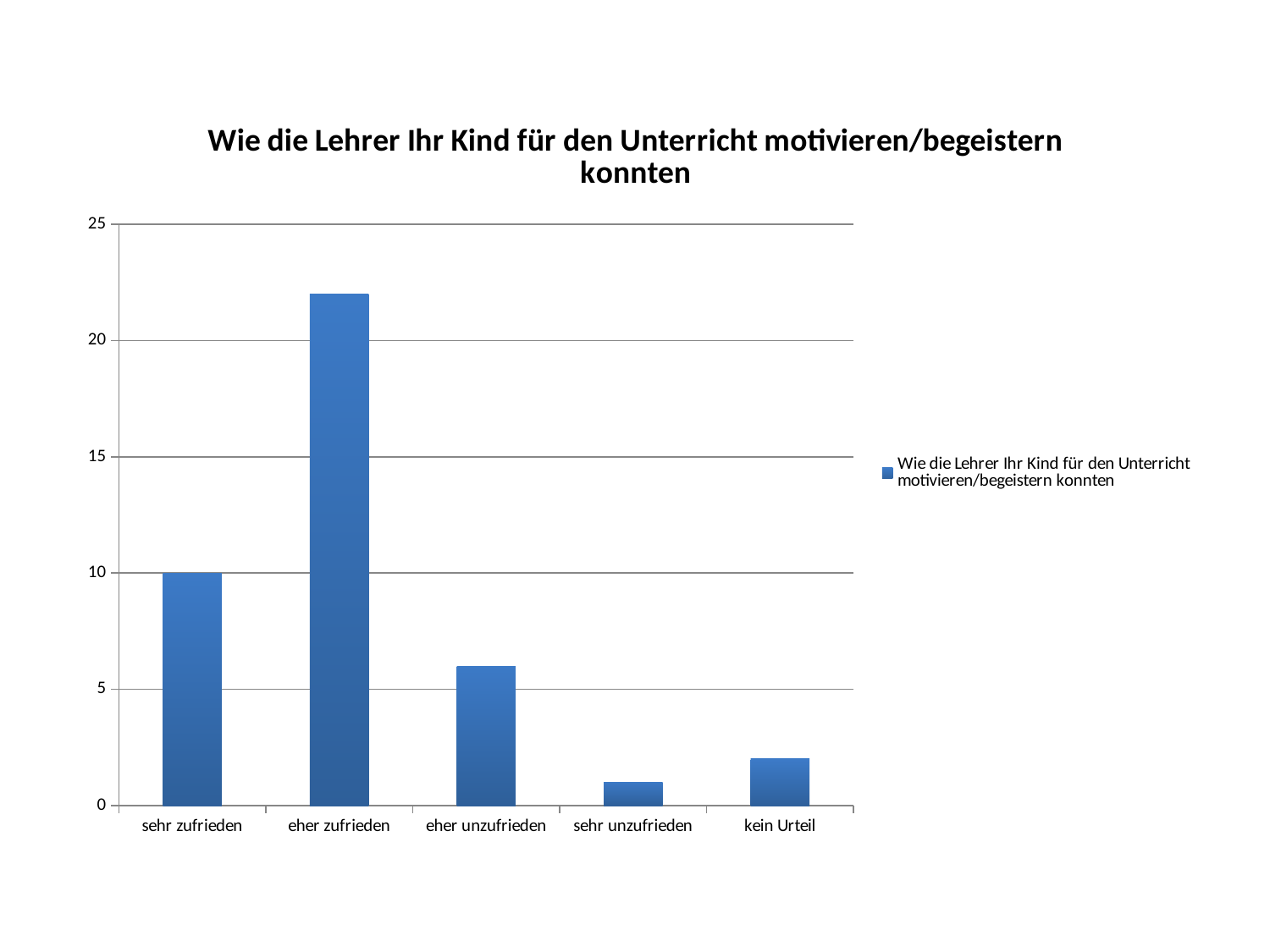
Which is larger, the value for 'sehr zufrieden' or the value for 'eher unzufrieden'? sehr zufrieden Which category has the highest value? eher zufrieden Is the value for 'eher zufrieden' greater or less than 20? greater Is the value for 'kein Urteil' greater or less than 5? less How many categories are shown on the x axis? 5 Which category has the lowest value? sehr unzufrieden What is the title of the chart? Wie die Lehrer Ihr Kind für den Unterricht motivieren/begeistern konnten Is the value for 'eher unzufrieden' greater or less than 5? greater What is the value for 'sehr zufrieden'? 10 What type of chart is shown on the slide? bar chart How many series does the legend list? 1 Which is larger, the value for 'kein Urteil' or the value for 'sehr unzufrieden'? kein Urteil